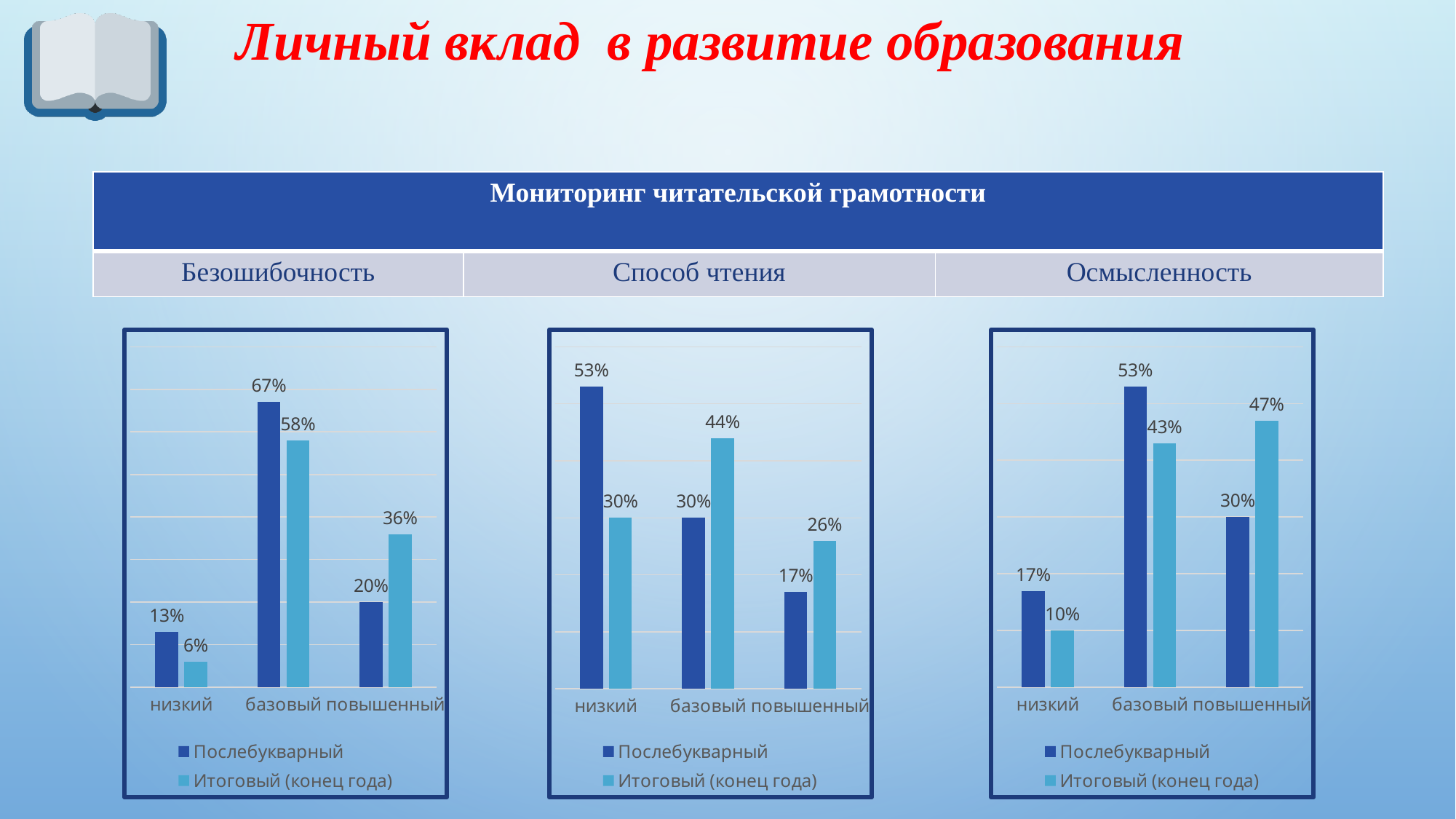
In the Способ чтения chart, what is the value for низкий in the Послебукварный series? 53% What type of chart is the Осмысленность chart? Bar chart How many series does the legend of the Безошибочность chart list? 2 In the Осмысленность chart, what is the difference between the Послебукварный and Итоговый (конец года) values for базовый? 10% In the Осмысленность chart, what is the value for повышенный in the Итоговый (конец года) series? 47% In the Способ чтения chart, which category has the highest Итоговый (конец года) value? базовый In the Способ чтения chart, which is larger for базовый: Послебукварный or Итоговый (конец года)? Итоговый (конец года) In the Способ чтения chart, which category has the lowest Послебукварный value? повышенный In the Осмысленность chart, which category has the lowest Итоговый (конец года) value? низкий In the Безошибочность chart, what is the value for повышенный in the Итоговый (конец года) series? 36% In the Безошибочность chart, what is the value for базовый in the Послебукварный series? 67% In the Безошибочность chart, what is the difference between the Послебукварный and Итоговый (конец года) values for низкий? 7%